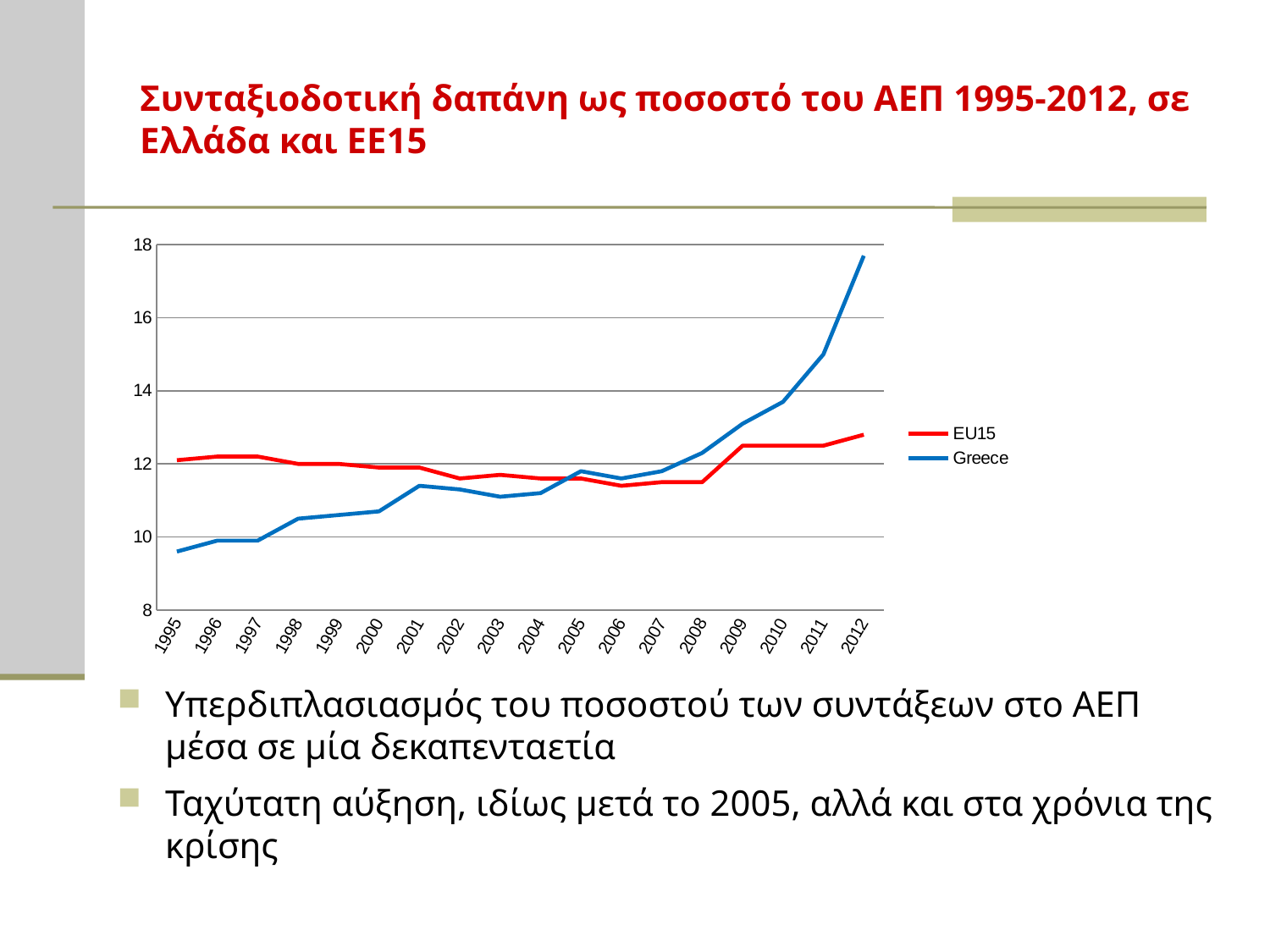
In which year does the Greece series have its lowest value? 1995 In 2012, which series has the higher value, EU15 or Greece? Greece Does the Greece line generally rise or fall from 1995 to 2012? rise Is the value for Greece in 2012 greater or less than 16? greater Is the value for Greece in 2011 greater or less than 14? greater In which year does the Greece series reach its highest value? 2012 Is the value for EU15 in 2006 greater or less than 12? less Which colour is used for the EU15 line? red What kind of chart is shown on the slide? line chart How many series does the legend list? 2 How many years are shown on the x axis? 18